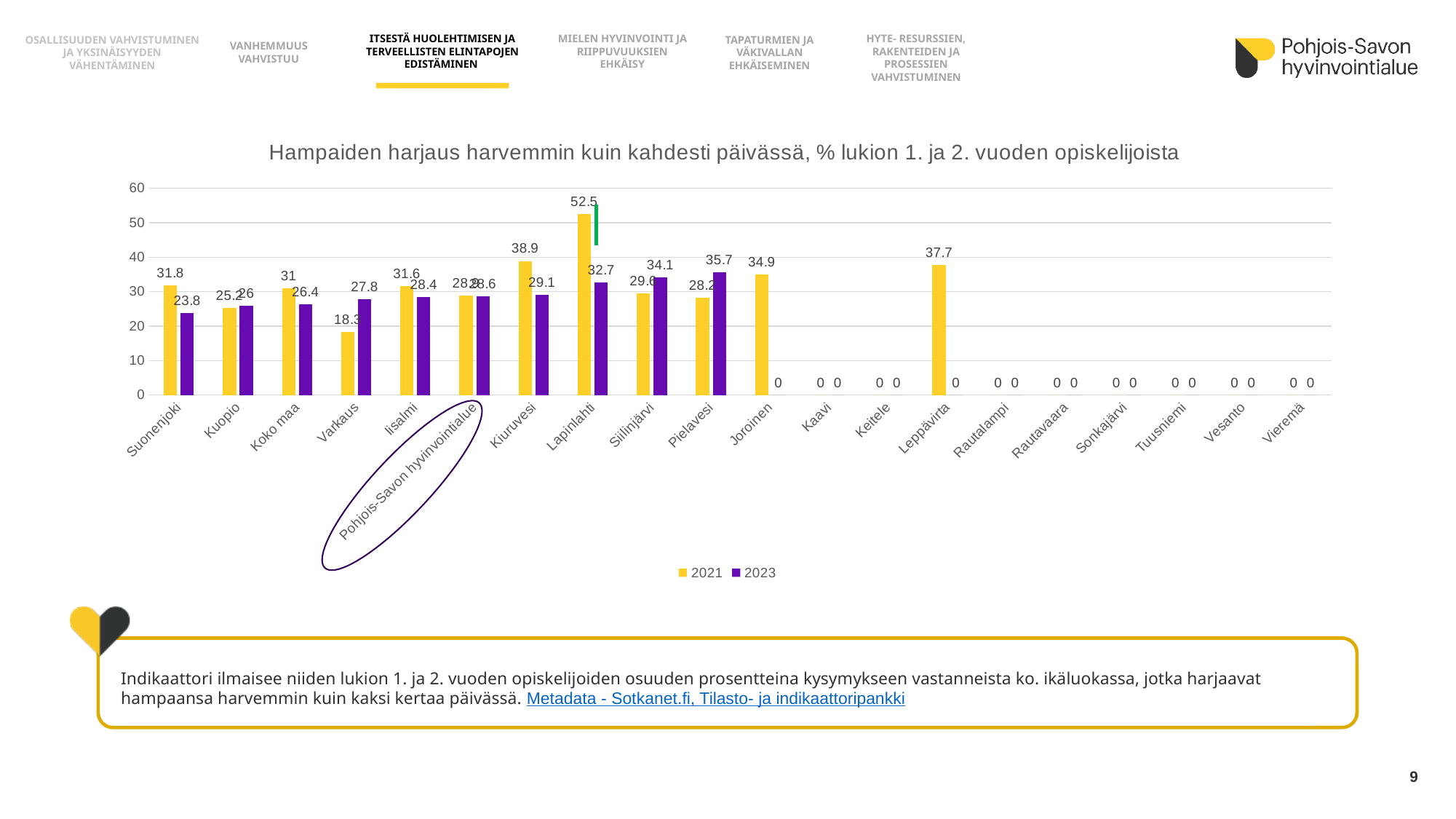
What is the 2023 value for Suonenjoki? 23.8 What is the 2021 value for Lapinlahti? 52.5 What is the 2021 value for Leppävirta? 37.7 What is the difference between the 2021 and 2023 values for Kiuruvesi? 9.8 Which is larger for Siilinjärvi, the 2021 value or the 2023 value? 2023 What is the 2023 value for Pielavesi? 35.7 What type of chart is shown on the slide? bar chart Which category has the highest 2023 value? Pielavesi How many series does the legend list? 2 What is the 2021 value for Varkaus? 18.3 Which series is shown in yellow in the legend? 2021 Which category has the highest 2021 value? Lapinlahti